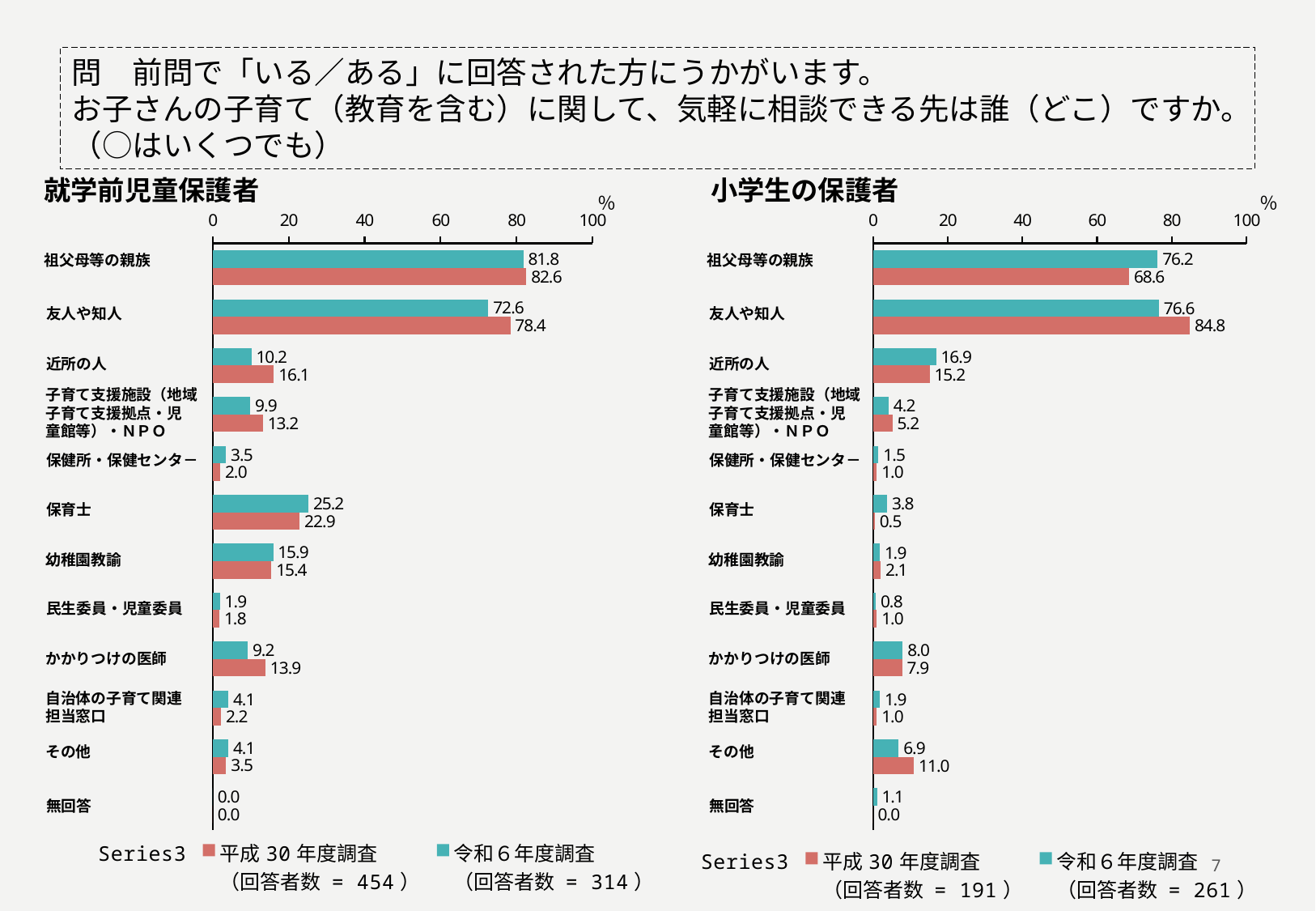
In the 小学生の保護者 chart, is the 平成30年度調査 value for 友人や知人 greater or less than 80? greater In the 小学生の保護者 chart, which category has the highest 平成30年度調査 value? 友人や知人 In the 小学生の保護者 chart, what is the 平成30年度調査 value for 友人や知人? 84.8 In the 就学前児童保護者 chart, what is the difference between the 平成30年度調査 and 令和６年度調査 values for 近所の人? 5.9 In the 就学前児童保護者 chart, which category has the highest 令和６年度調査 value? 祖父母等の親族 In the 小学生の保護者 chart, what is the difference between the 令和６年度調査 and 平成30年度調査 values for 祖父母等の親族? 7.6 In the 就学前児童保護者 chart, what is the 平成30年度調査 value for 友人や知人? 78.4 In the 就学前児童保護者 chart, what is the 令和６年度調査 value for 祖父母等の親族? 81.8 What type of chart is the 小学生の保護者 chart? bar chart In the 小学生の保護者 chart, what is the 令和６年度調査 value for かかりつけの医師? 8.0 How many categories are listed in the 就学前児童保護者 chart? 12 In the 就学前児童保護者 chart, which is larger for 保育士: the 平成30年度調査 value or the 令和６年度調査 value? 令和６年度調査